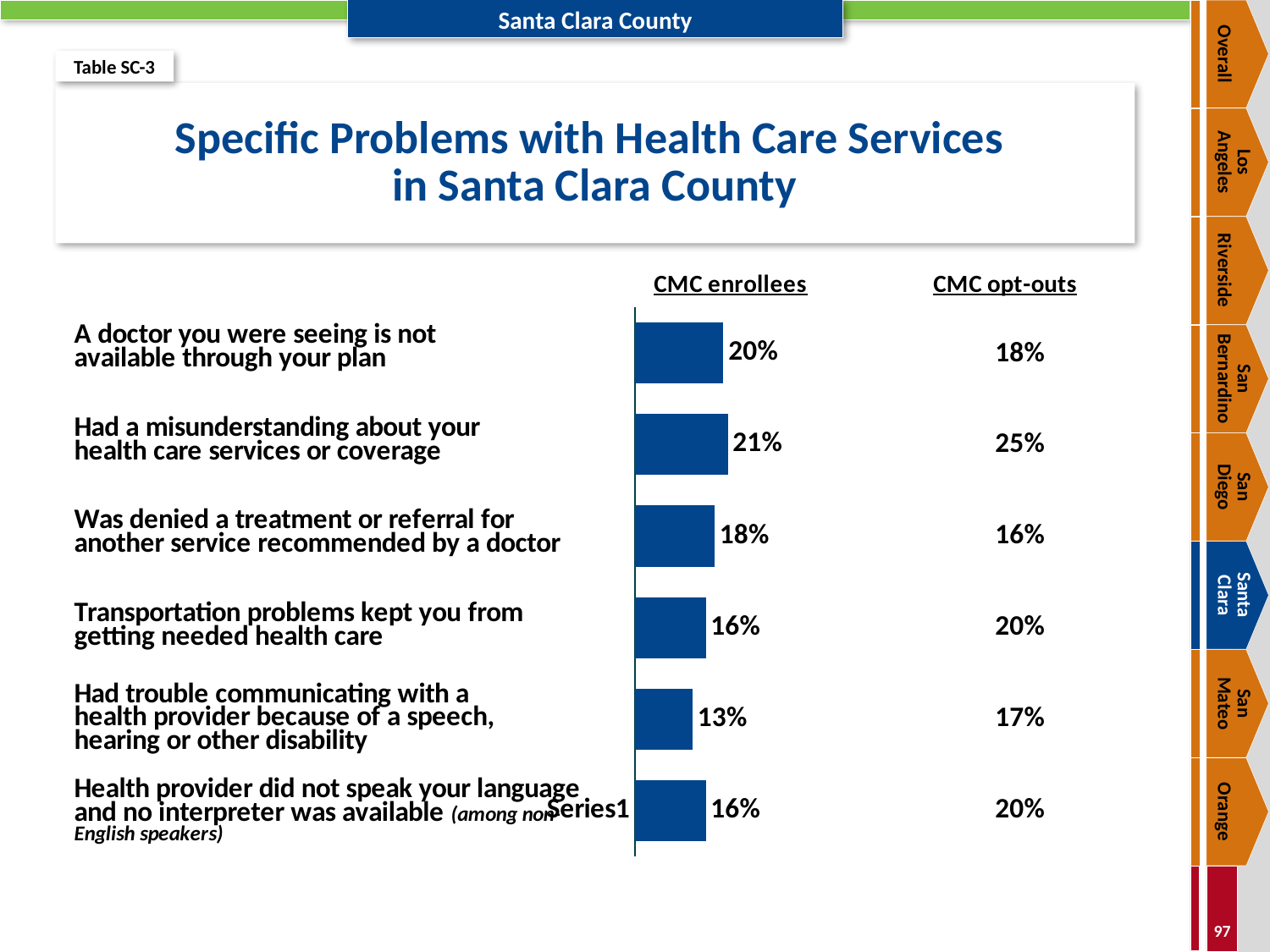
What percentage of CMC enrollees reported that a doctor they were seeing is not available through their plan? 20% What is the title of the chart on the slide? Specific Problems with Health Care Services in Santa Clara County What percentage of CMC enrollees had trouble communicating with a health provider because of a speech, hearing or other disability? 13% What is the difference between the CMC opt-outs and CMC enrollees percentages for transportation problems keeping you from getting needed health care? 4% What kind of chart is used to show the CMC enrollees percentages? Bar chart Which problem has the lowest percentage among CMC enrollees? Had trouble communicating with a health provider because of a speech, hearing or other disability What percentage of CMC enrollees said transportation problems kept them from getting needed health care? 16% What is the difference between the CMC enrollees percentage for a misunderstanding about health care services or coverage and for trouble communicating due to a disability? 8% How many problem categories are plotted as bars in the chart? 6 Which problem has the highest percentage among CMC enrollees? Had a misunderstanding about your health care services or coverage What percentage of CMC enrollees had a misunderstanding about their health care services or coverage? 21% Among CMC enrollees, which is larger: the percentage for a doctor not available through the plan or the percentage for being denied a treatment or referral? A doctor you were seeing is not available through your plan